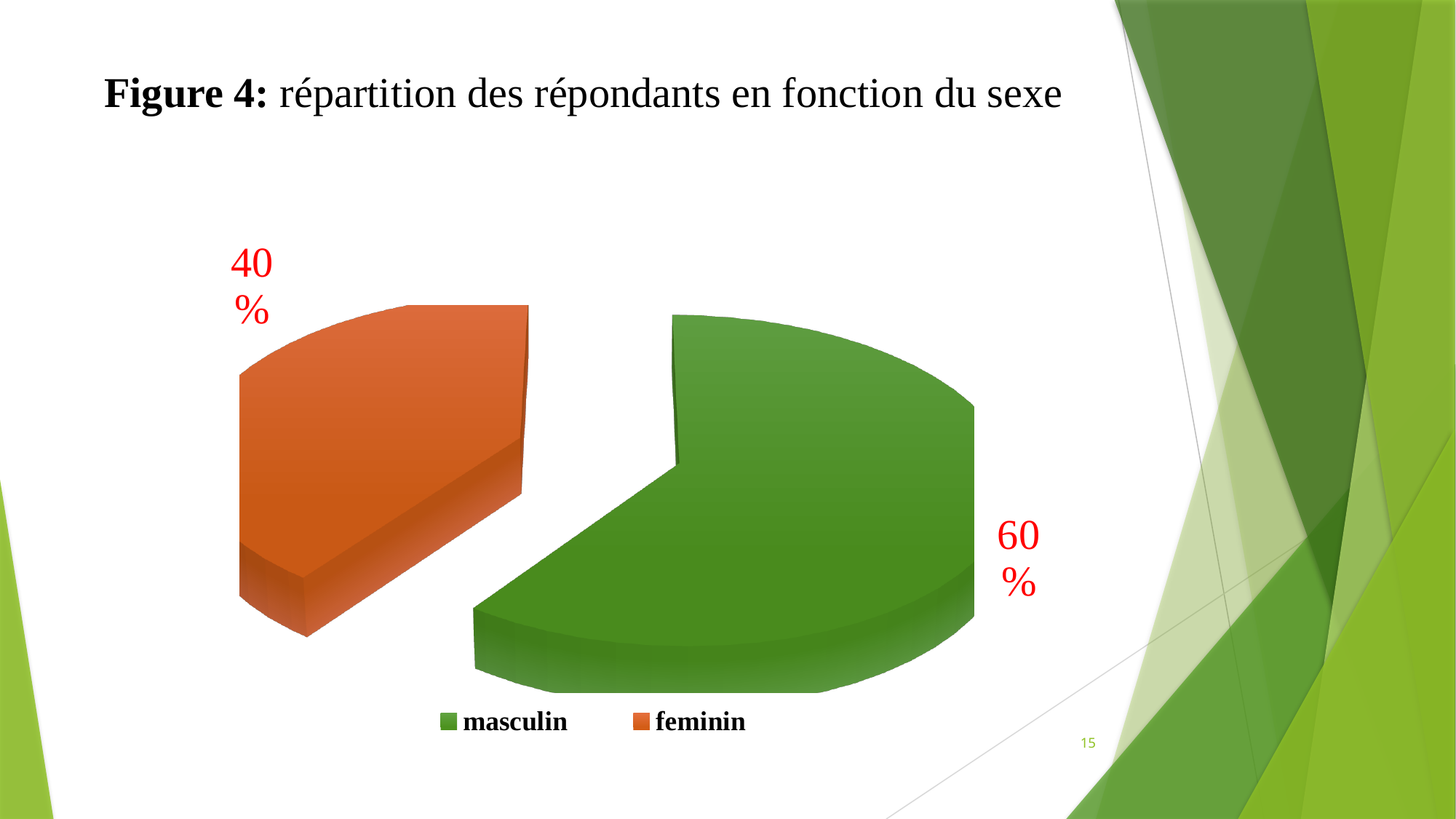
What colour is the masculin slice? green What is the difference in percentage points between masculin and feminin? 20 Which category has the largest share of the pie? masculin Which is larger, the masculin slice or the feminin slice? masculin What kind of chart is shown on the slide? pie chart How many categories does the pie chart show? 2 What share of respondents is feminin? 40% What share of respondents is masculin? 60% What is the total of the two slices shown? 100% How many entries does the legend list? 2 Which category has the smallest share of the pie? feminin What is the title of the figure on the slide? Figure 4: répartition des répondants en fonction du sexe